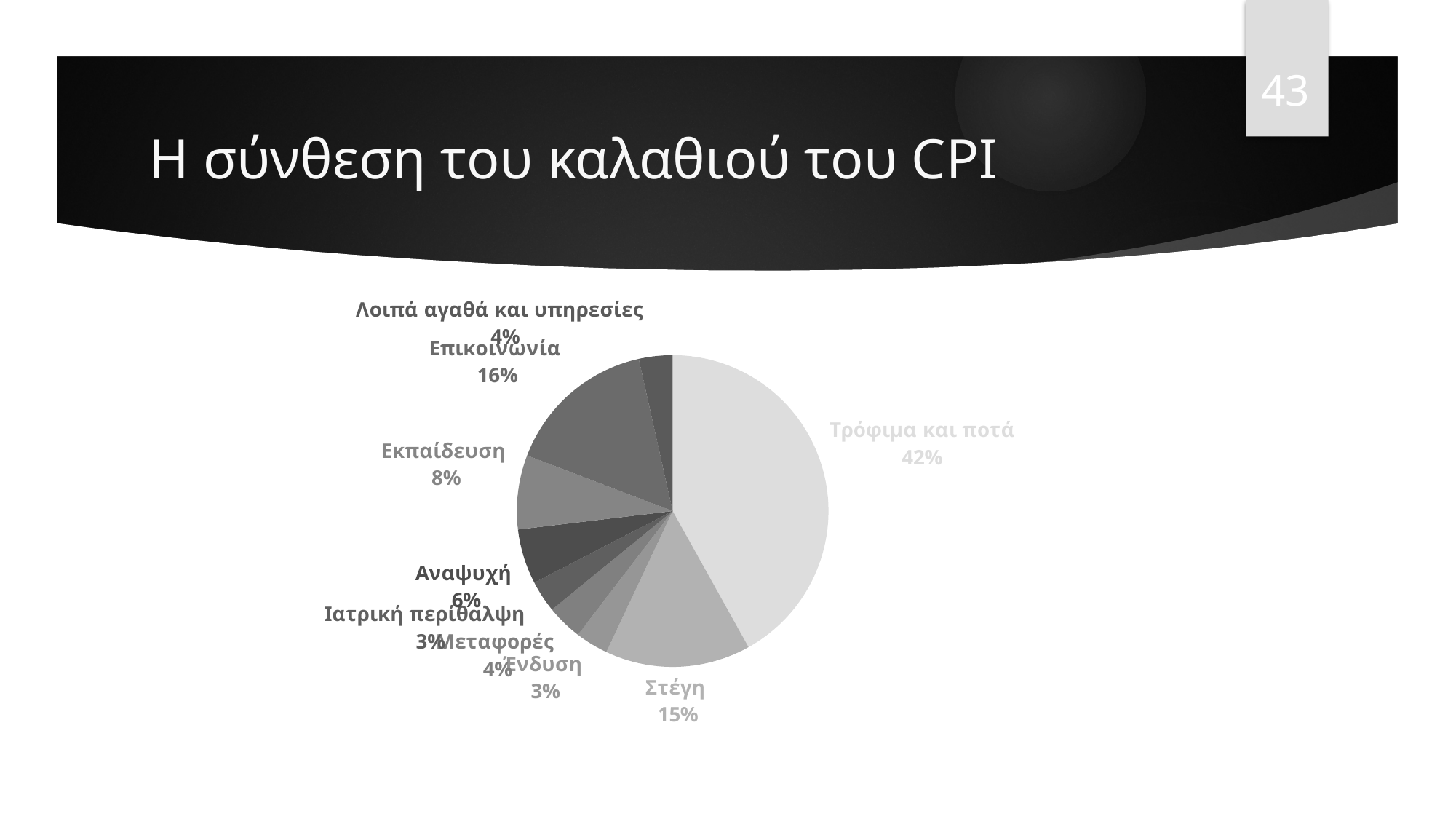
What is the share of Επικοινωνία in the pie chart? 16% What is the difference in percentage points between Τρόφιμα και ποτά and Επικοινωνία? 26 What is the title of the slide containing the pie chart? Η σύνθεση του καλαθιού του CPI What is the share of Τρόφιμα και ποτά in the pie chart? 42% What is the share of Εκπαίδευση in the pie chart? 8% Which is larger, the share of Στέγη or the share of Εκπαίδευση? Στέγη How many categories are shown in the pie chart? 9 What type of chart is shown on the slide? pie chart What is the share of Λοιπά αγαθά και υπηρεσίες in the pie chart? 4% What is the share of Στέγη in the pie chart? 15% What is the difference in percentage points between Επικοινωνία and Στέγη? 1 Which category has the largest slice of the pie chart? Τρόφιμα και ποτά